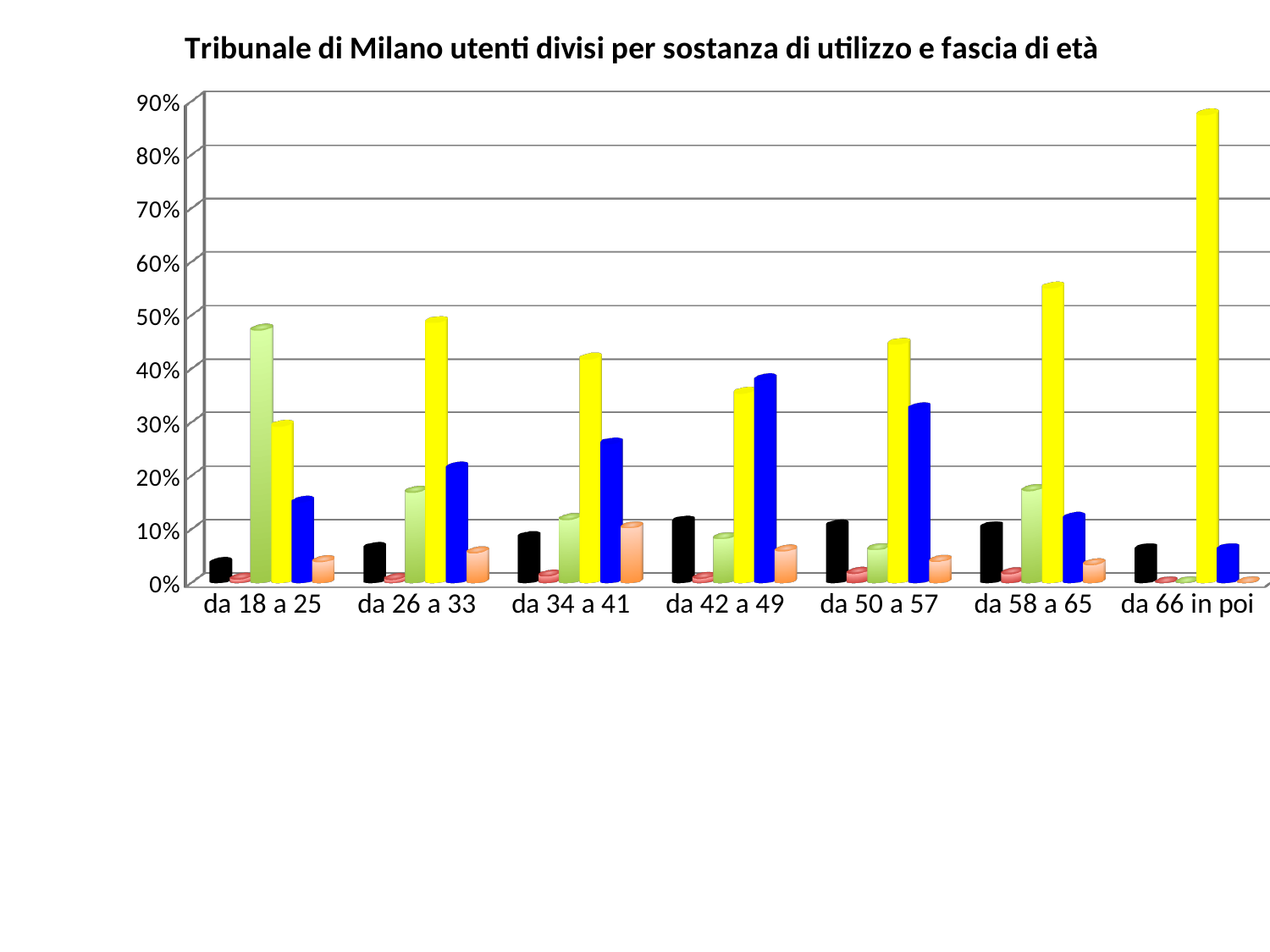
Which age group has the tallest yellow bar? da 66 in poi In the 'da 50 a 57' group, which is larger, the yellow bar or the blue bar? yellow bar Is the yellow bar for 'da 58 a 65' greater or less than 50%? greater What kind of chart is shown on the slide? bar chart What is the title of the chart? Tribunale di Milano utenti divisi per sostanza di utilizzo e fascia di età Is the yellow bar for 'da 18 a 25' greater or less than 40%? less What is the highest value shown on the y axis? 90% How many age-group categories are shown on the x axis? 7 Is the light green bar for 'da 18 a 25' greater or less than 40%? greater Which age group has the tallest light green bar? da 18 a 25